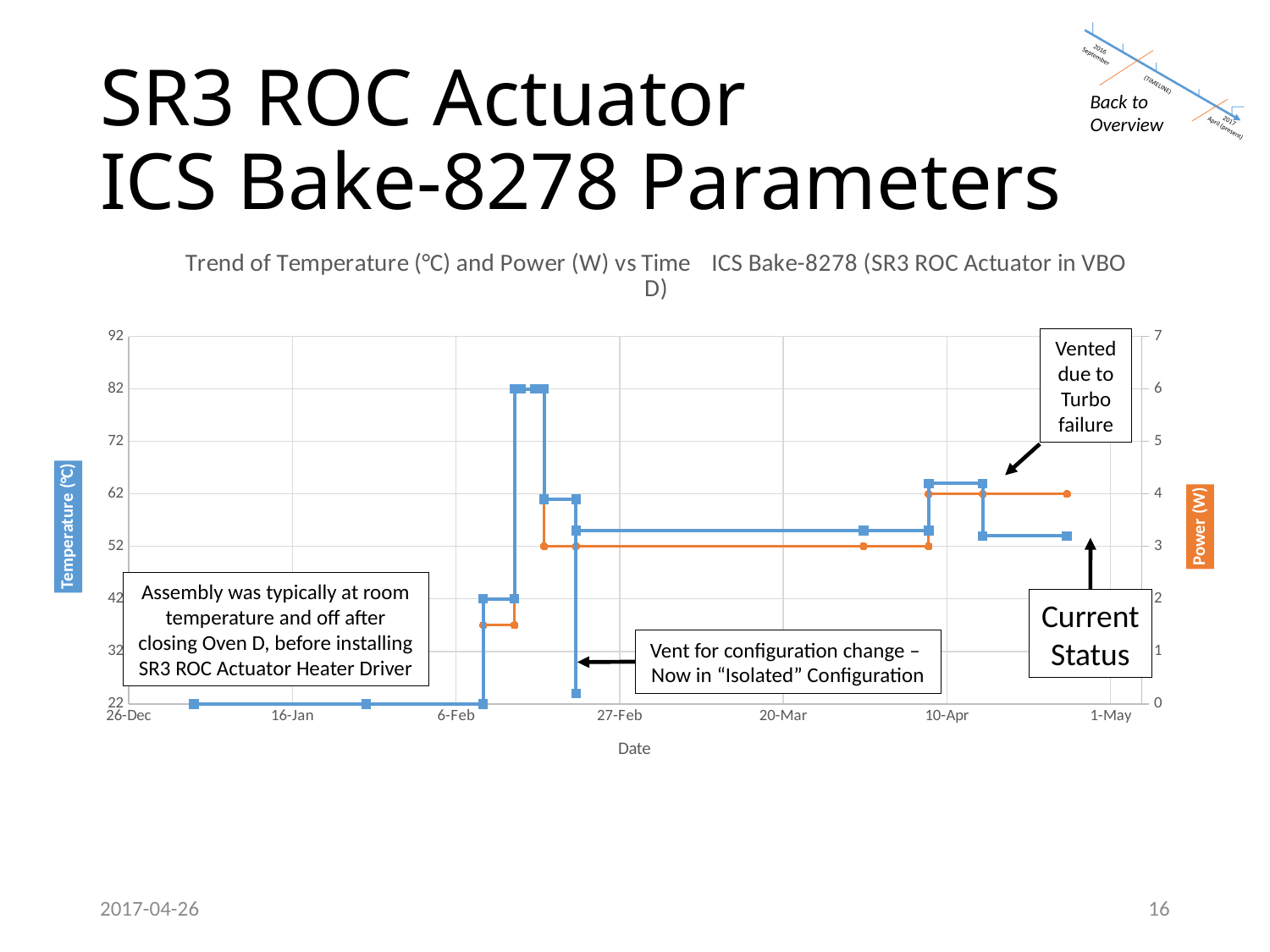
What is the title of the x axis? Date What is the highest power value reached by the orange Power line? 6 Is the power value around 20-Mar greater or less than 5? less Which is larger, the temperature at 26-Dec or the temperature at the end of the series near the end of April? the temperature near the end of April What type of chart is shown on the slide? line chart Is the temperature value around 20-Mar greater or less than 42? greater What is the highest temperature reached by the blue Temperature line? 82 Does the temperature line rise or fall between 6-Feb and the peak in mid-February? rise What is the temperature value of the blue line at 26-Dec? 22 What is the power value of the orange line around 20-Mar? 3 What is the title of the right-hand vertical axis? Power (W) Is the temperature value around 20-Mar greater or less than 62? less